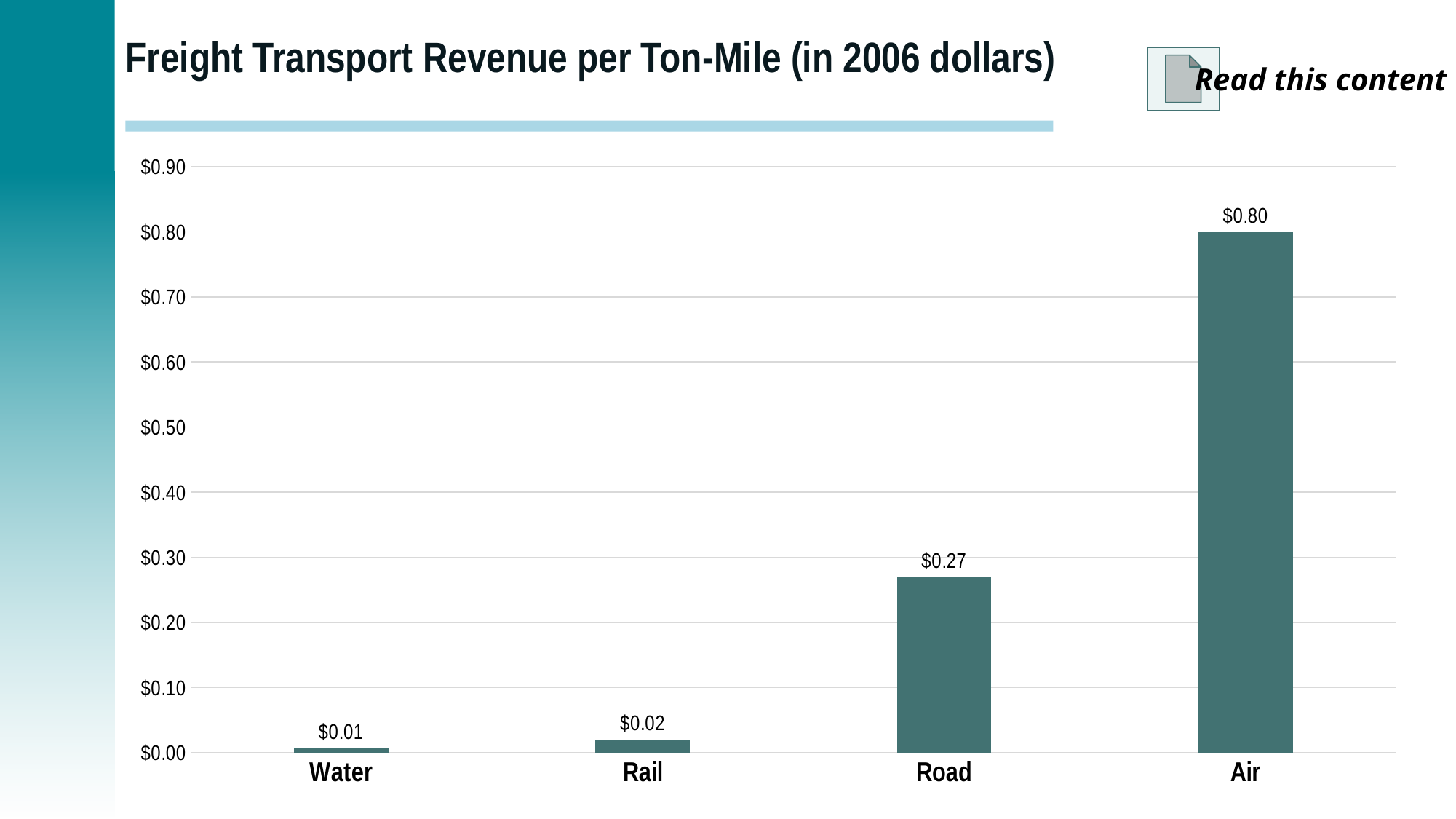
Which has a higher revenue per ton-mile, Road or Rail? Road What is the difference in revenue per ton-mile between Air and Road? $0.53 Is the value for Road greater or less than $0.30? less How many transport modes are shown on the chart? 4 Which transport mode has the lowest revenue per ton-mile? Water What is the title of the chart? Freight Transport Revenue per Ton-Mile (in 2006 dollars) What is the revenue per ton-mile for Air? $0.80 What is the revenue per ton-mile for Rail? $0.02 What is the revenue per ton-mile for Road? $0.27 What kind of chart is shown on the slide? Bar chart What is the revenue per ton-mile for Water? $0.01 Which transport mode has the highest revenue per ton-mile? Air